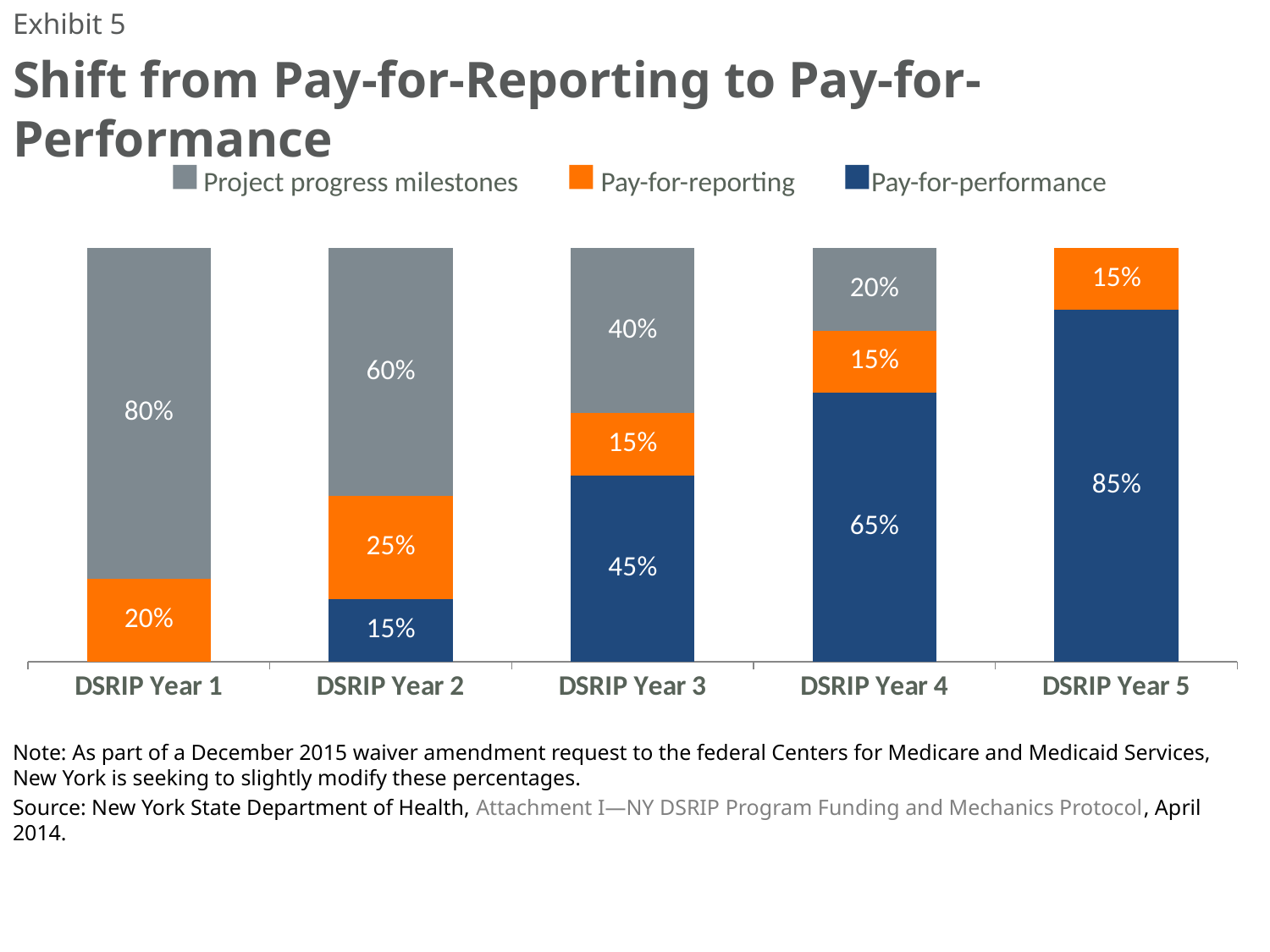
Does the Pay-for-performance value rise or fall from DSRIP Year 2 to DSRIP Year 5? Rise What is the Project progress milestones value for DSRIP Year 2? 60% Which DSRIP year has the highest Pay-for-performance value? DSRIP Year 5 How many DSRIP years are shown on the x axis? 5 How many series does the legend list? 3 Which DSRIP year has the lowest Project progress milestones value among the years where it is shown? DSRIP Year 4 What is the Pay-for-reporting value for DSRIP Year 1? 20% What is the total of the stacked bar for DSRIP Year 3? 100% What kind of chart is shown? Stacked bar chart What is the difference between the Pay-for-performance values for DSRIP Year 5 and DSRIP Year 2? 70% What is the Pay-for-performance value for DSRIP Year 3? 45% Which is larger: the Pay-for-reporting value for DSRIP Year 2 or for DSRIP Year 4? DSRIP Year 2